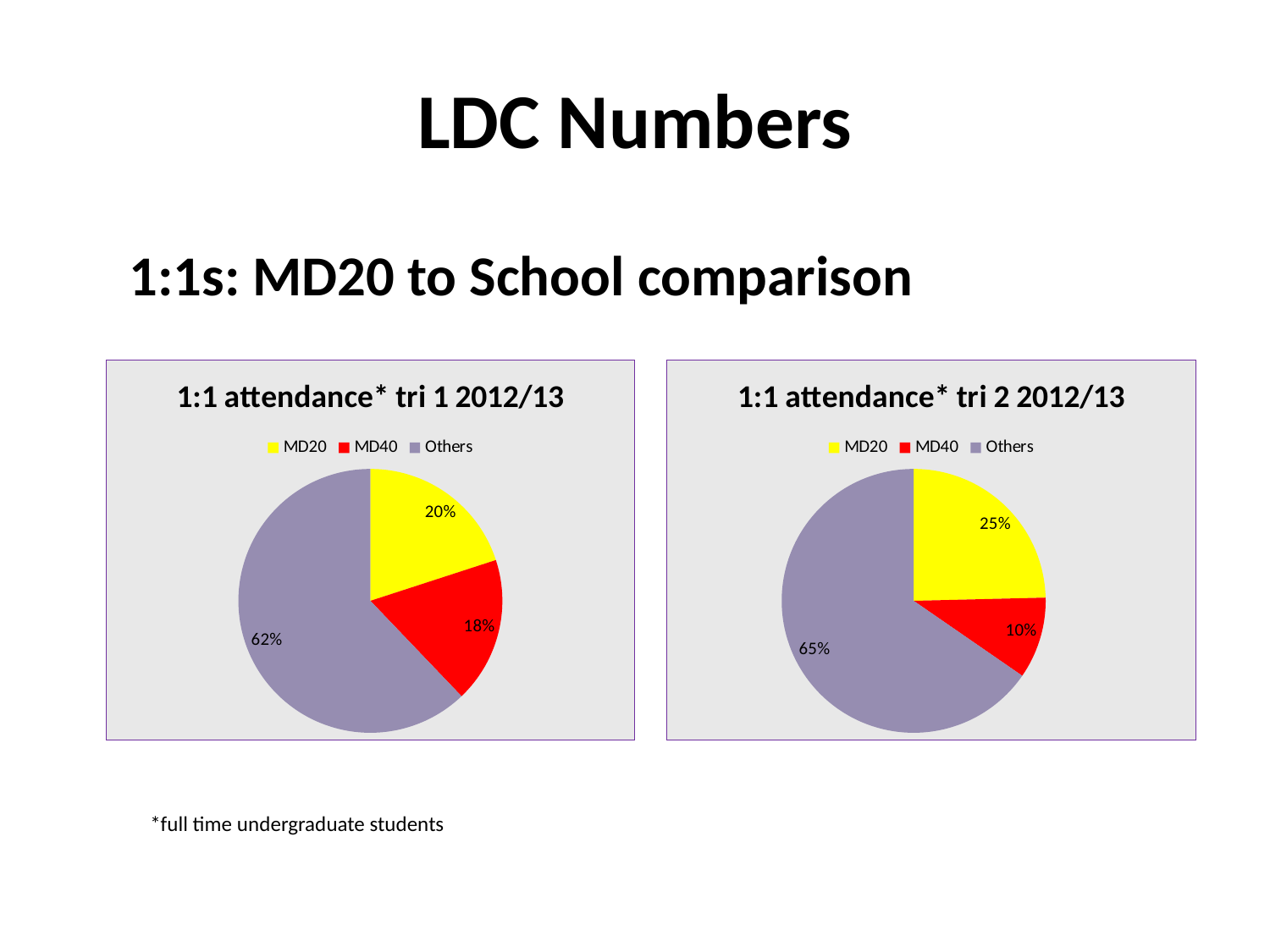
What type of chart is the '1:1 attendance* tri 2 2012/13' chart? Pie chart In the '1:1 attendance* tri 1 2012/13' chart, what colour is the MD40 slice? Red In the '1:1 attendance* tri 1 2012/13' chart, how many slices does the pie have? 3 In the '1:1 attendance* tri 2 2012/13' chart, what share does MD40 have? 10% In the '1:1 attendance* tri 2 2012/13' chart, what share does MD20 have? 25% In the '1:1 attendance* tri 2 2012/13' chart, what is the difference between the MD20 and MD40 shares? 15% In the '1:1 attendance* tri 1 2012/13' chart, what share does MD40 have? 18% In the '1:1 attendance* tri 1 2012/13' chart, which category has the largest slice? Others In the '1:1 attendance* tri 2 2012/13' chart, which category has the smallest slice? MD40